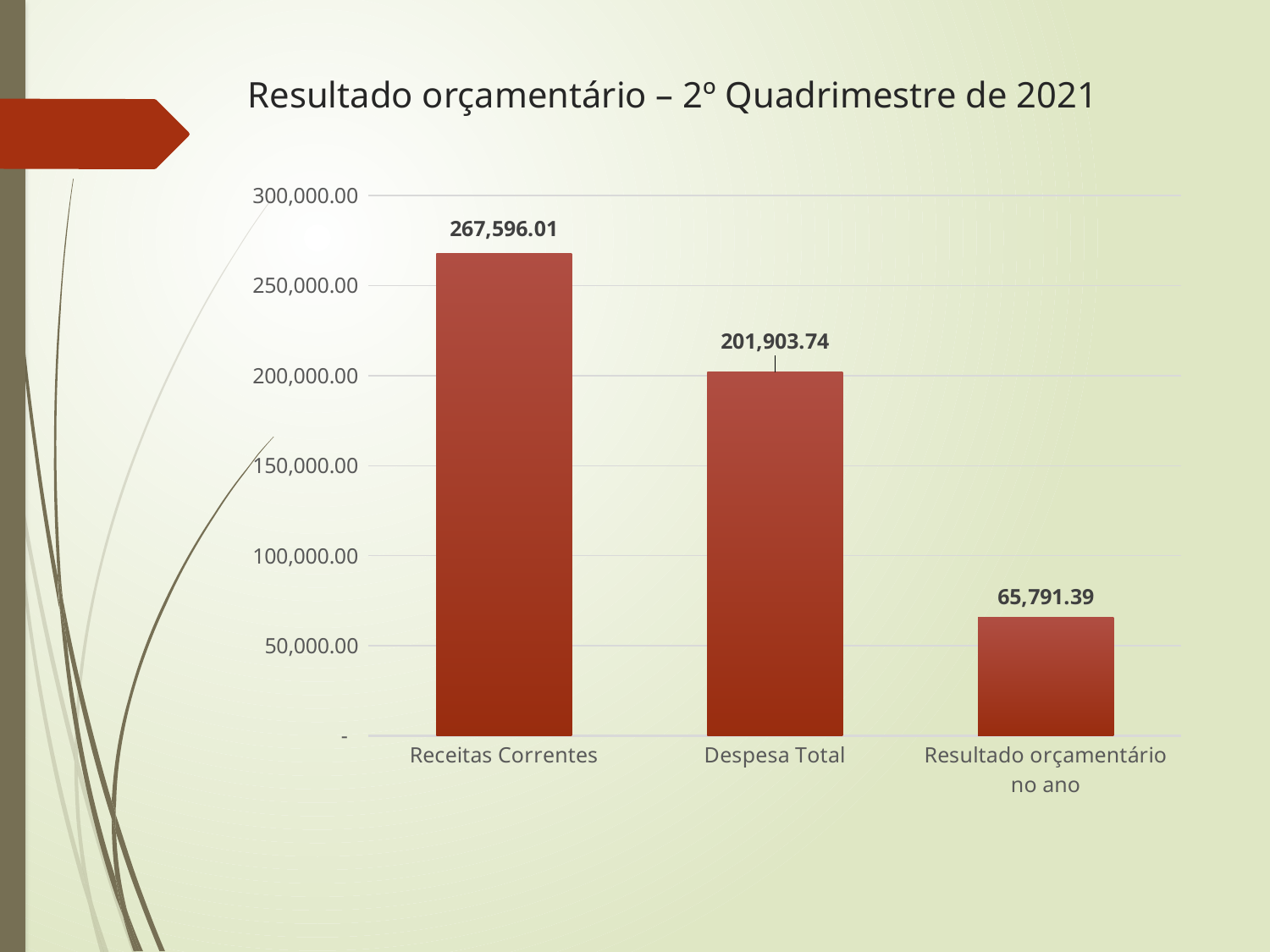
What is the difference between Receitas Correntes and Despesa Total? 65,692.27 What is the title of the slide? Resultado orçamentário – 2º Quadrimestre de 2021 Which is larger, Despesa Total or Resultado orçamentário no ano? Despesa Total Is the value for Despesa Total greater or less than 250,000.00? less How many categories are shown in the chart? 3 What kind of chart is shown on the slide? bar chart What is the value for Resultado orçamentário no ano? 65,791.39 Which category has the lowest value? Resultado orçamentário no ano Which category has the highest value? Receitas Correntes What is the value for Despesa Total? 201,903.74 What is the value for Receitas Correntes? 267,596.01 What is the difference between Despesa Total and Resultado orçamentário no ano? 136,112.35